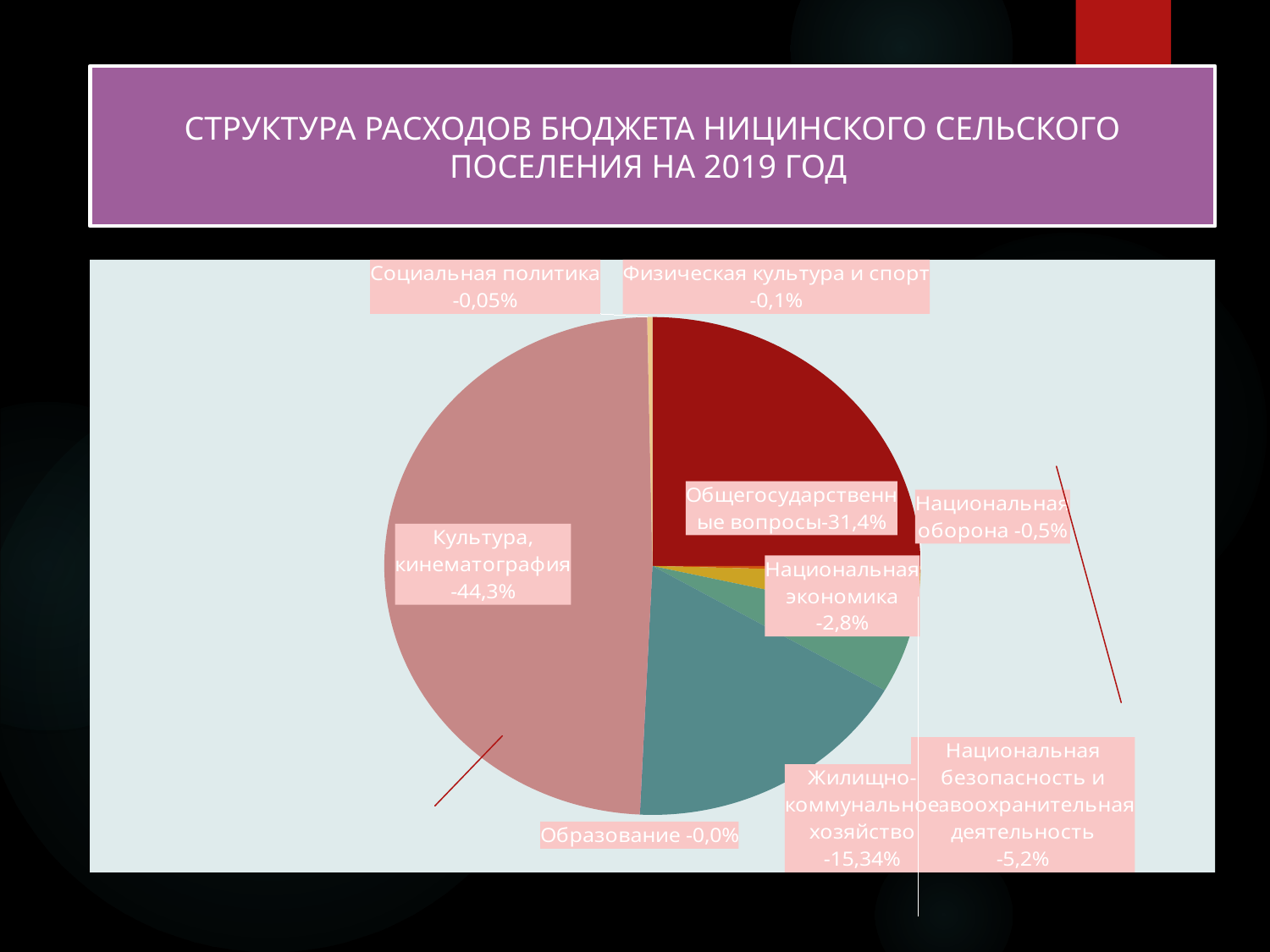
What is the title of the slide? СТРУКТУРА РАСХОДОВ БЮДЖЕТА НИЦИНСКОГО СЕЛЬСКОГО ПОСЕЛЕНИЯ НА 2019 ГОД Which is larger: the share of Жилищно-коммунальное хозяйство or the share of Национальная безопасность и правоохранительная деятельность? Жилищно-коммунальное хозяйство What is the value shown for Национальная безопасность и правоохранительная деятельность? 5,2% What is the value shown for Национальная экономика? 2,8% Which category has the largest share of the pie? Культура, кинематография Which category has the smallest share of the pie? Образование How many categories are shown in the pie chart? 9 What type of chart is shown on the slide? Pie chart What is the difference between the shares of Культура, кинематография and Общегосударственные вопросы? 12,9% What is the value shown for Общегосударственные вопросы? 31,4% What is the value shown for Жилищно-коммунальное хозяйство? 15,34% What share of the pie does Культура, кинематография account for? 44,3%